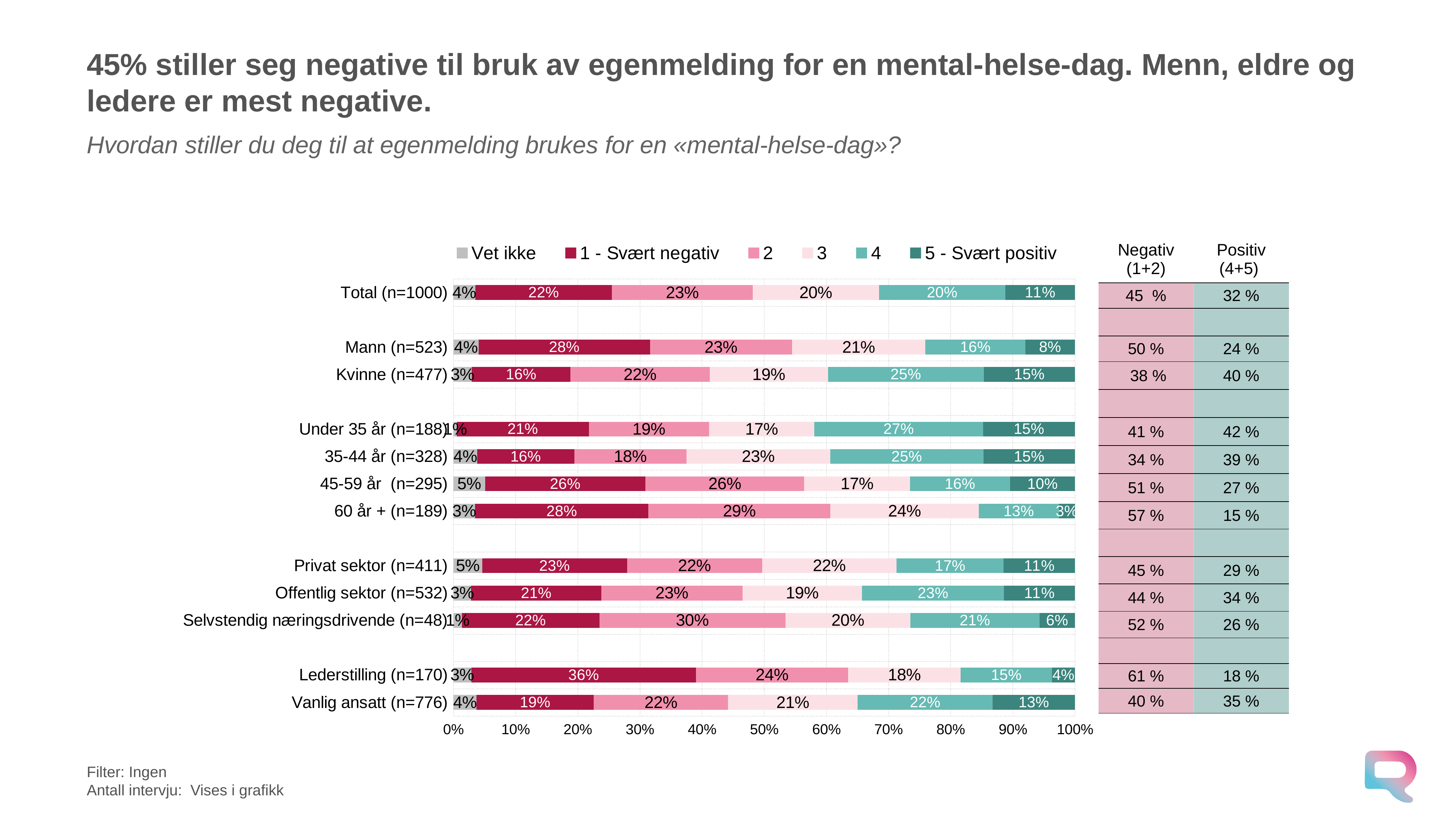
What is the value of series '2' for Selvstendig næringsdrivende (n=48)? 30% What is the value of '1 - Svært negativ' for Lederstilling (n=170)? 36% Which has the larger value for '5 - Svært positiv', Mann (n=523) or Kvinne (n=477)? Kvinne (n=477) What is the value of series '4' for Kvinne (n=477)? 25% How many series does the legend list? 6 What is the difference in '1 - Svært negativ' between Mann (n=523) and Kvinne (n=477)? 12 percentage points What is the value of '5 - Svært positiv' for 60 år + (n=189)? 3% Which category has the lowest value for '5 - Svært positiv'? 60 år + (n=189) What kind of chart is shown on the slide? Stacked bar chart How many categories (groups) are plotted in the chart? 12 Which category has the highest value for '1 - Svært negativ'? Lederstilling (n=170) What is the first series listed in the legend? Vet ikke